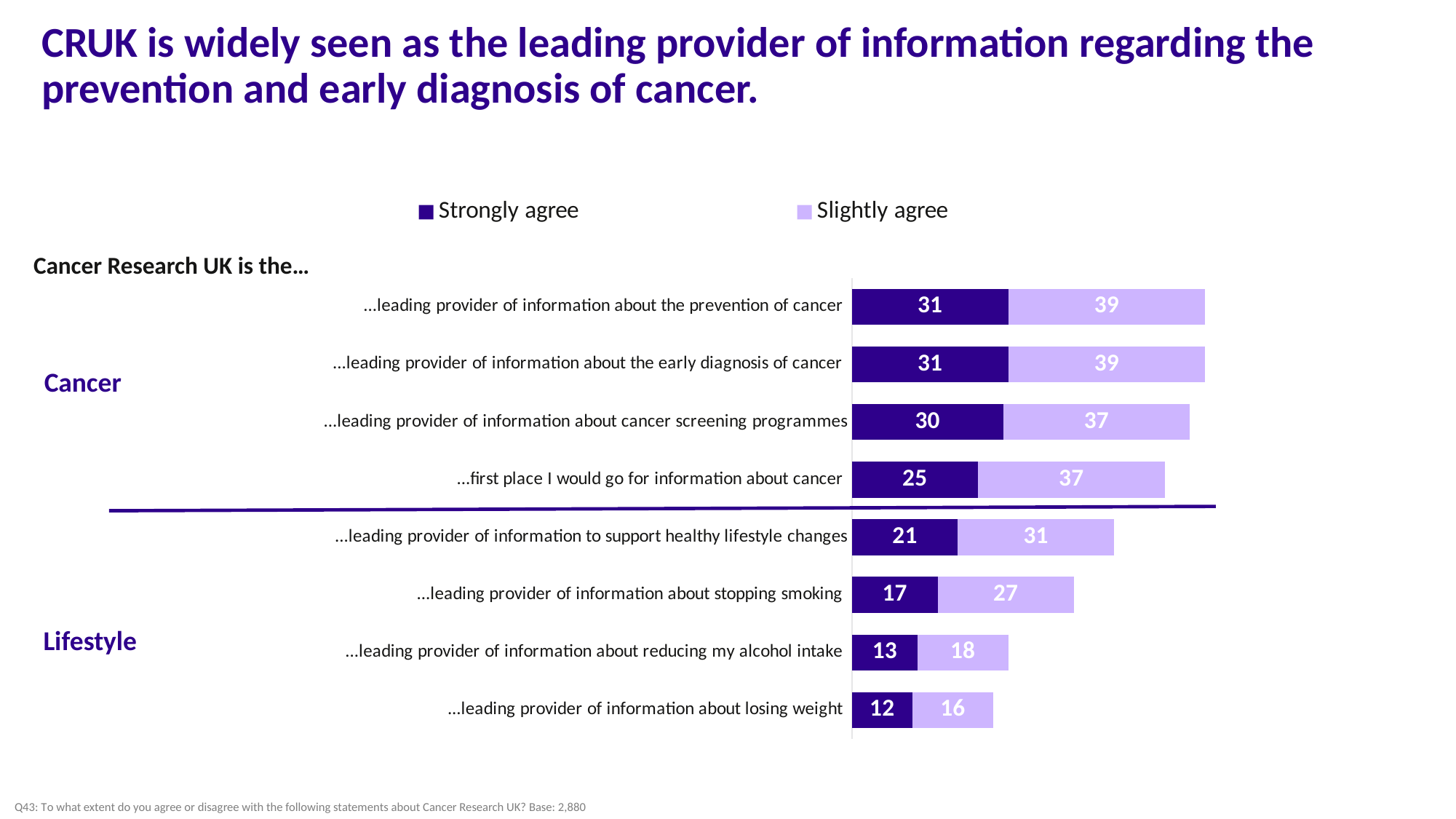
What are the two group labels shown to the left of the chart? Cancer and Lifestyle What kind of chart is shown on the slide? Stacked bar chart What is the 'Slightly agree' value for '...leading provider of information about stopping smoking'? 27 What is the total of the stacked bar for '...first place I would go for information about cancer'? 62 Which is larger: the 'Strongly agree' value for '...leading provider of information to support healthy lifestyle changes' or for '...leading provider of information about stopping smoking'? ...leading provider of information to support healthy lifestyle changes What is the 'Strongly agree' value for '...leading provider of information about the prevention of cancer'? 31 Which statement has the lowest 'Strongly agree' value? ...leading provider of information about losing weight What is the total of the stacked bar for '...leading provider of information about reducing my alcohol intake'? 31 What is the 'Strongly agree' value for '...leading provider of information about losing weight'? 12 How many series does the legend list? 2 What is the difference between the 'Slightly agree' values for '...leading provider of information about the early diagnosis of cancer' and '...leading provider of information about losing weight'? 23 How many statements are plotted in the chart? 8